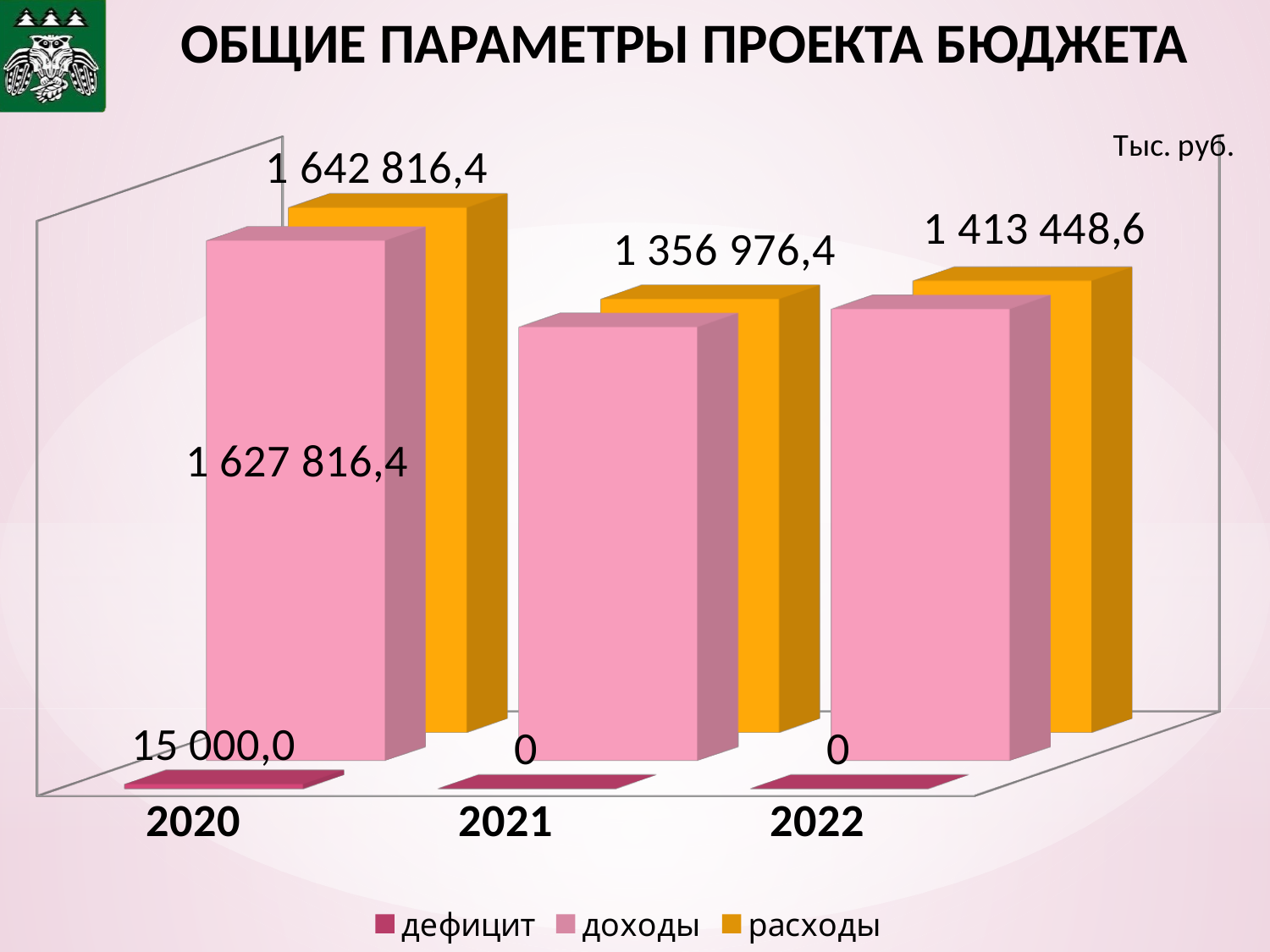
What is the value of расходы for 2022? 1 413 448,6 What is the value of дефицит for 2020? 15 000,0 How many series does the legend list? 3 What is the value of расходы for 2021? 1 356 976,4 In which year is расходы the highest? 2020 In which year is расходы the lowest? 2021 What is the value of дефицит for 2021? 0 What is the difference between расходы and доходы in 2020? 15 000,0 Which is larger: расходы in 2020 or расходы in 2022? расходы in 2020 What is the value of доходы for 2020? 1 627 816,4 What unit of measurement is indicated on the chart? Тыс. руб. What is the value of расходы for 2020? 1 642 816,4